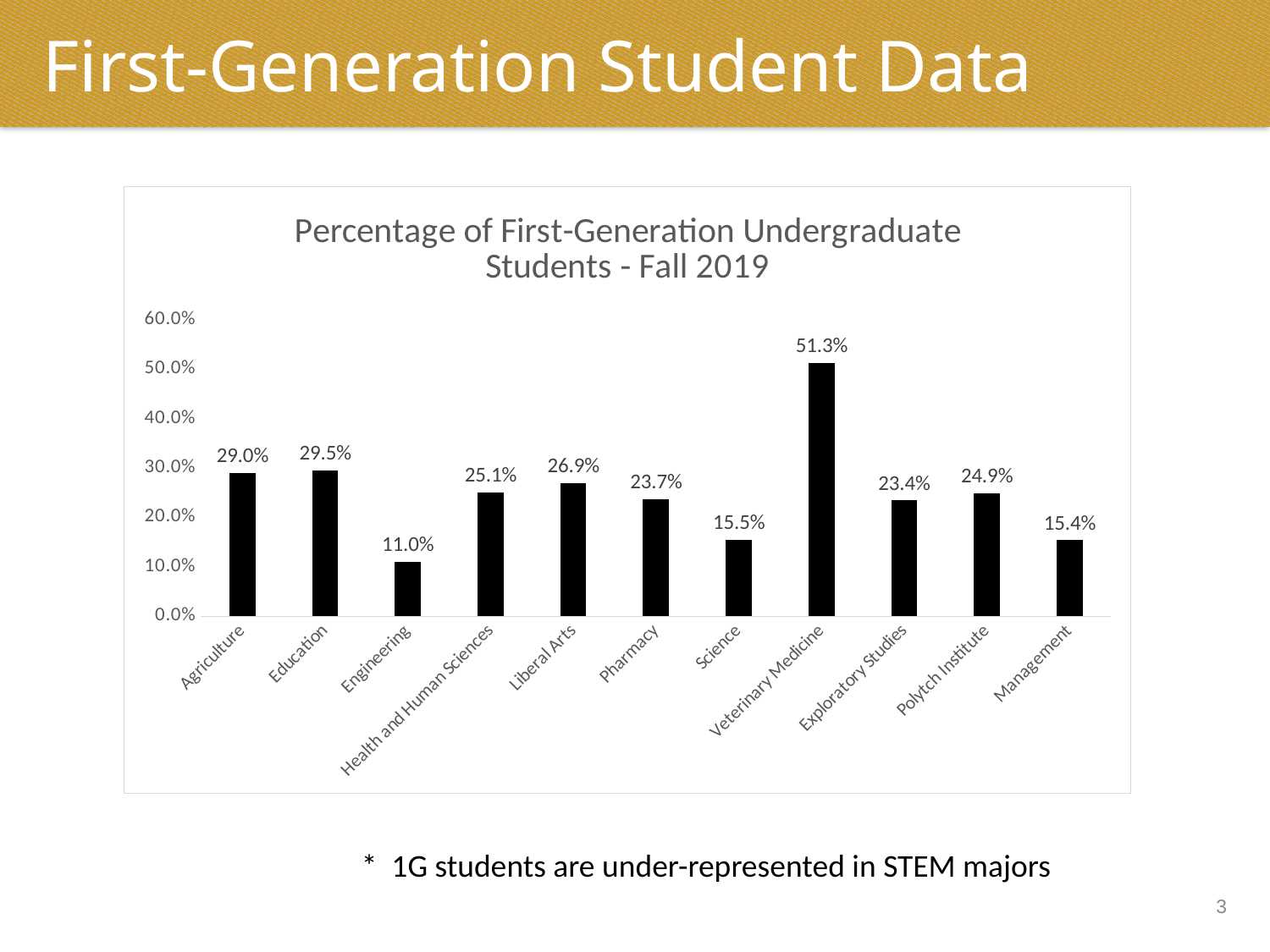
What is the percentage of first-generation undergraduate students in Engineering? 11.0% What is the difference between the percentages for Veterinary Medicine and Engineering? 40.3% Which category has the highest percentage of first-generation undergraduate students? Veterinary Medicine Is the value for Science greater or less than 20.0%? less What is the title of the chart? Percentage of First-Generation Undergraduate Students - Fall 2019 What is the percentage of first-generation undergraduate students in Veterinary Medicine? 51.3% How many categories are shown on the x axis of the chart? 11 Which category has the lowest percentage of first-generation undergraduate students? Engineering Which has a higher percentage of first-generation students, Liberal Arts or Pharmacy? Liberal Arts What kind of chart is shown on the slide? Bar chart What is the percentage of first-generation undergraduate students in Health and Human Sciences? 25.1% What is the difference between the percentages for Education and Agriculture? 0.5%